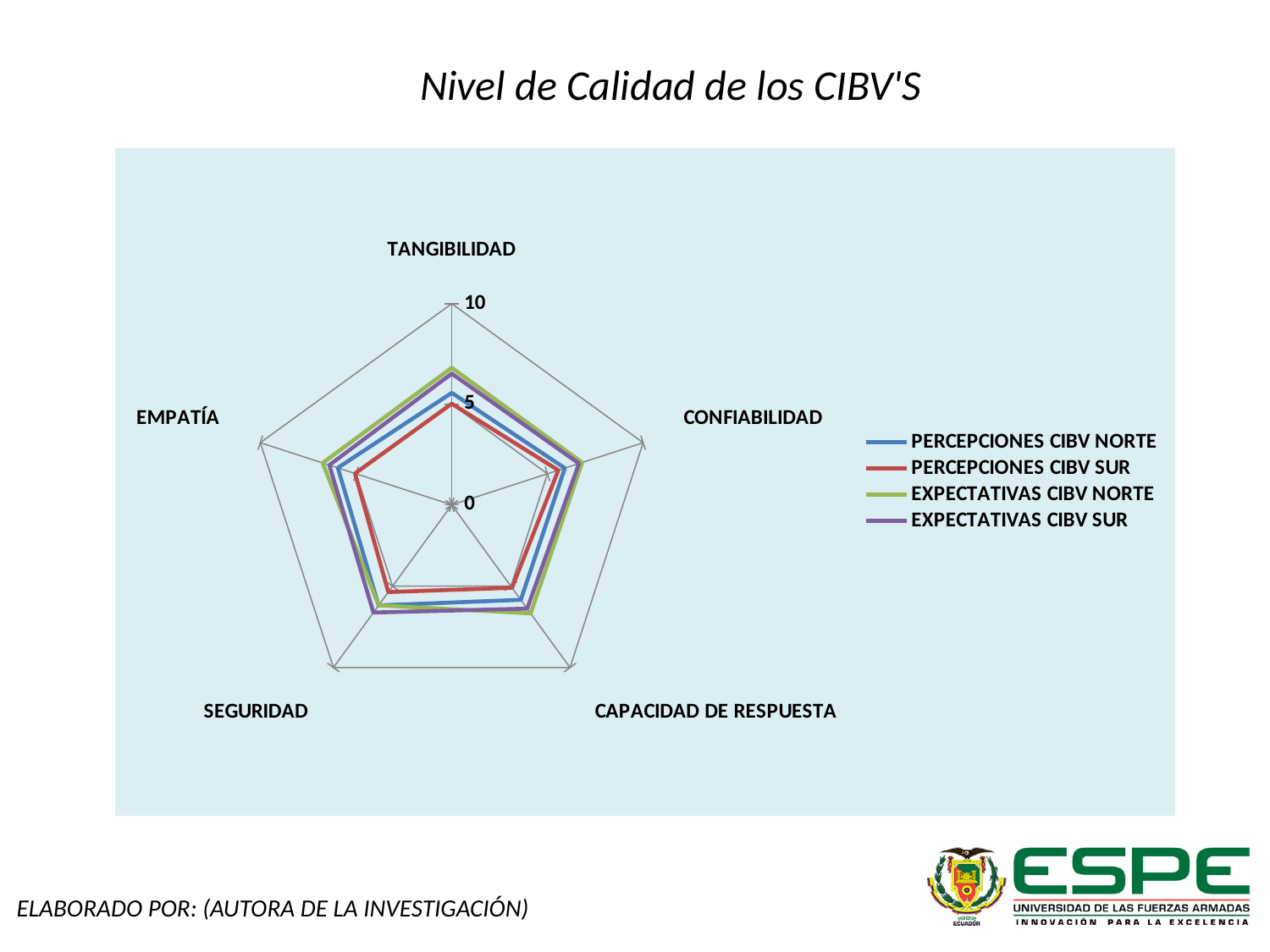
Is the value for EXPECTATIVAS CIBV NORTE on CONFIABILIDAD greater or less than 10? less Is the value for PERCEPCIONES CIBV NORTE on CAPACIDAD DE RESPUESTA greater or less than 5? greater How many categories (axes) does the radar chart have? 5 What kind of chart is shown on the slide? Radar chart Is the value for EXPECTATIVAS CIBV NORTE on TANGIBILIDAD greater or less than 5? greater Which series is drawn in green in the legend? EXPECTATIVAS CIBV NORTE Which series has the highest value on TANGIBILIDAD? EXPECTATIVAS CIBV NORTE What is the title of the chart? Nivel de Calidad de los CIBV'S Which series has the lowest value on CONFIABILIDAD? PERCEPCIONES CIBV SUR How many series does the legend list? 4 On TANGIBILIDAD, which is larger: EXPECTATIVAS CIBV NORTE or PERCEPCIONES CIBV SUR? EXPECTATIVAS CIBV NORTE